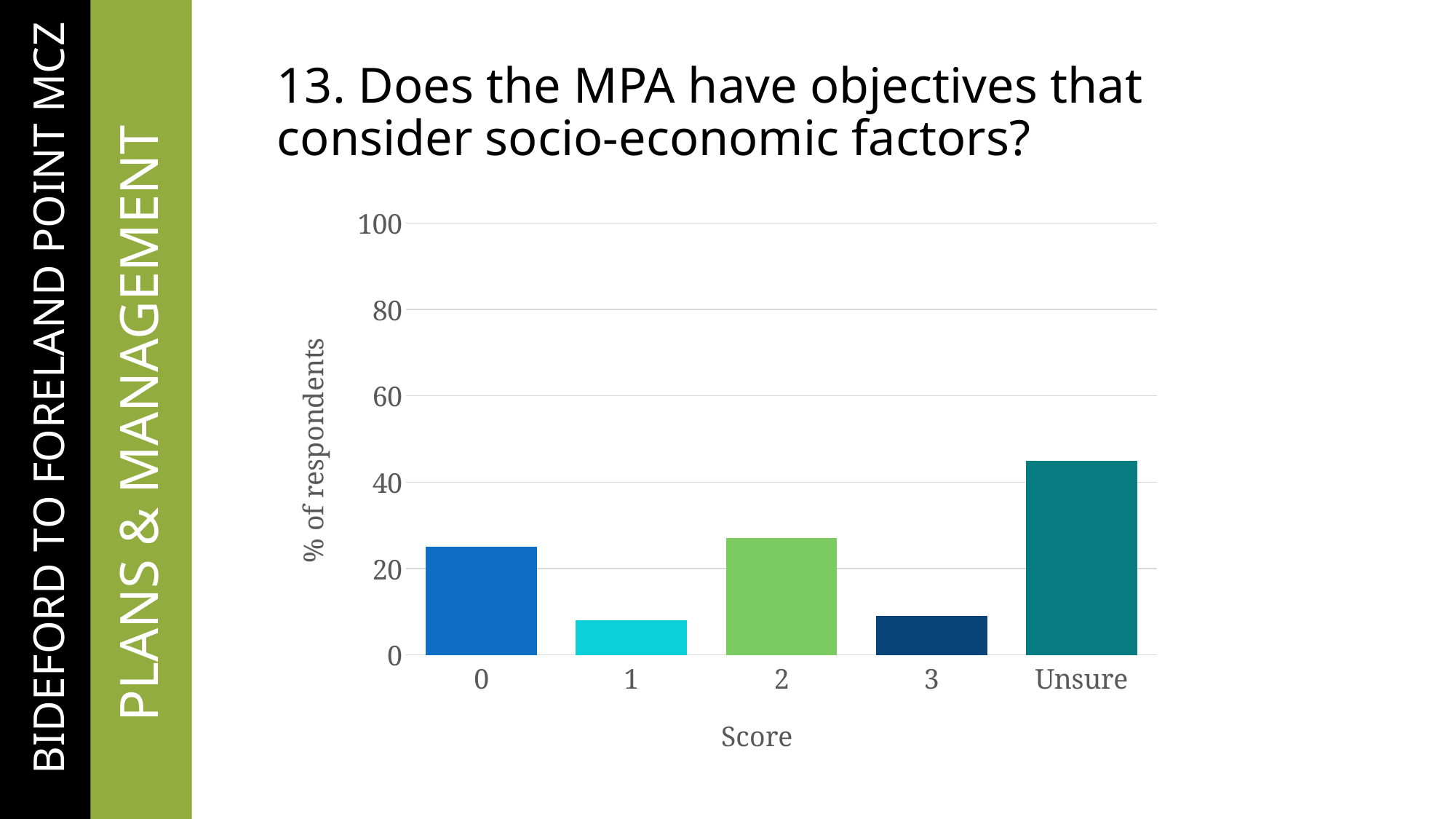
Is the value for score 1 greater or less than 20? less Is the value for score 0 greater or less than 20? greater Which has a larger percentage of respondents, score 0 or Unsure? Unsure What kind of chart is shown on the slide? bar chart What is the label on the vertical axis of the chart? % of respondents What is the label on the horizontal axis of the chart? Score Is the value for Unsure greater or less than 60? less Which has a larger percentage of respondents, score 2 or score 1? score 2 Which score category has the highest percentage of respondents? Unsure How many score categories are shown on the x axis of the chart? 5